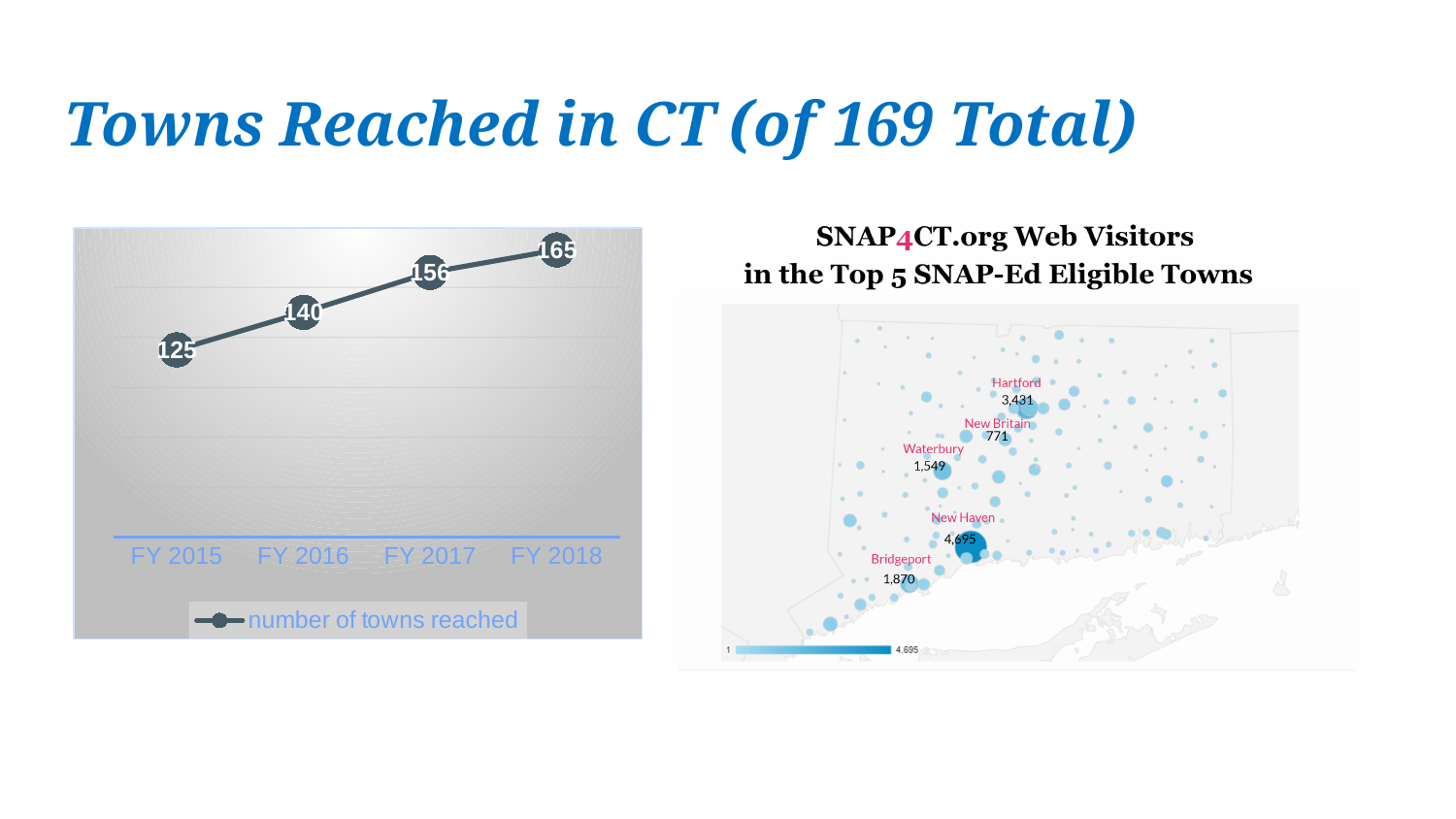
On the line chart on the left, what is the number of towns reached in FY 2017? 156 On the line chart on the left, which fiscal year has the lowest number of towns reached? FY 2015 On the line chart on the left, what series name does the legend show? number of towns reached On the line chart on the left, what is the number of towns reached in FY 2015? 125 On the line chart on the left, which fiscal year has the highest number of towns reached? FY 2018 On the SNAP4CT.org Web Visitors map, which of the top 5 towns has the fewest web visitors? New Britain What kind of chart is shown on the left of the slide? line chart On the line chart on the left, do the values rise or fall from FY 2015 to FY 2018? rise On the line chart on the left, what is the number of towns reached in FY 2018? 165 On the line chart on the left, how many fiscal years are plotted? 4 On the line chart on the left, what is the difference between the number of towns reached in FY 2018 and FY 2015? 40 On the SNAP4CT.org Web Visitors map, how many web visitors are shown for New Haven? 4,695